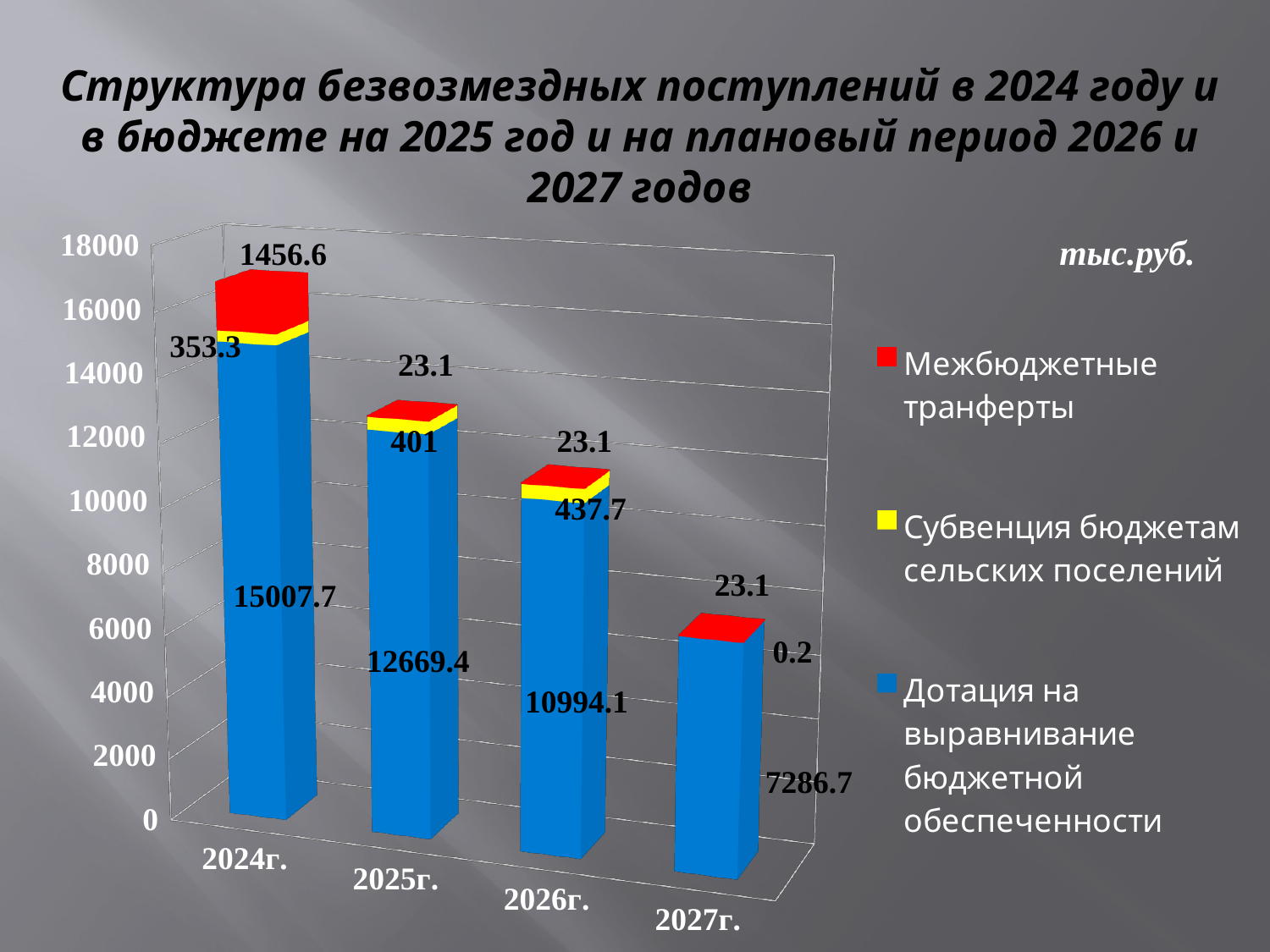
How many years (categories) are shown on the x axis? 4 Which year has the highest value of Межбюджетные трансферты? 2024г. How does the Дотация на выравнивание бюджетной обеспеченности value change from 2024г. to 2027г.? It falls What is the difference between the Дотация на выравнивание бюджетной обеспеченности values for 2024г. and 2025г.? 2338.3 What type of chart is shown on the slide? bar chart What is the value of Субвенция бюджетам сельских поселений for 2027г.? 0.2 What is the value of Межбюджетные трансферты for 2024г.? 1456.6 How many series does the legend list? 3 What is the value of Субвенция бюджетам сельских поселений for 2026г.? 437.7 What is the total of the stacked bar for 2025г.? 13093.5 What is the value of Дотация на выравнивание бюджетной обеспеченности for 2024г.? 15007.7 Which year has the lowest value of Дотация на выравнивание бюджетной обеспеченности? 2027г.